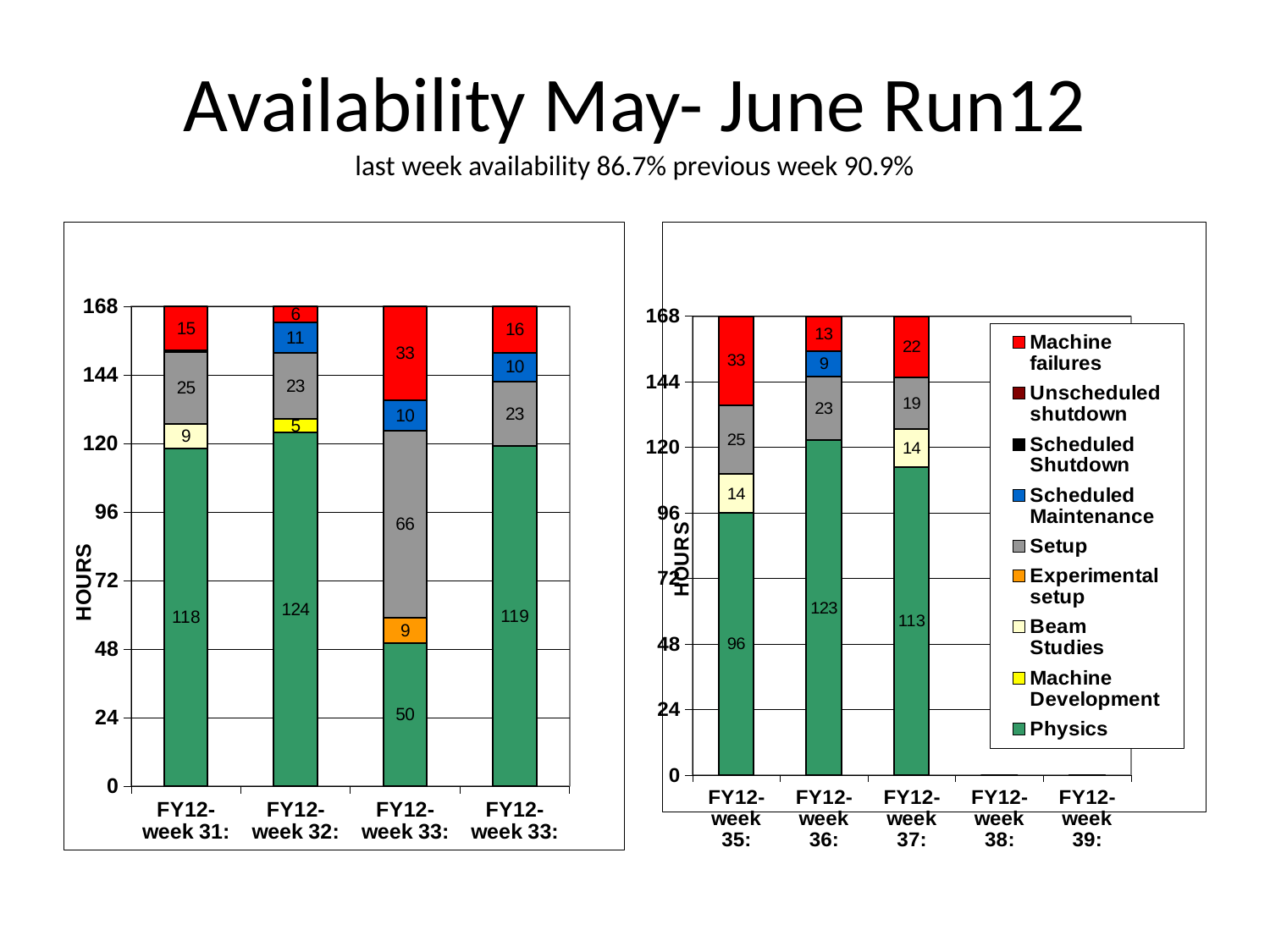
In the right chart, how many week categories are shown on the x axis? 5 How many series does the legend of the right chart list? 9 What kind of chart is the left chart? Stacked bar chart In the right chart, how many Physics hours are shown for FY12-week 36? 123 In the right chart, what is the difference in Machine failures hours between FY12-week 35 and FY12-week 37? 11 In the left chart, which has more Physics hours, FY12-week 31 or FY12-week 32? FY12-week 32 In the right chart, which week has the highest Physics hours? FY12-week 36 In the right chart, what is the Machine failures value for FY12-week 35? 33 In the right chart, what is the total height of the FY12-week 36 stacked bar? 168 In the left chart, what is the Setup value for FY12-week 31? 25 In the left chart, how many Physics hours are shown for FY12-week 32? 124